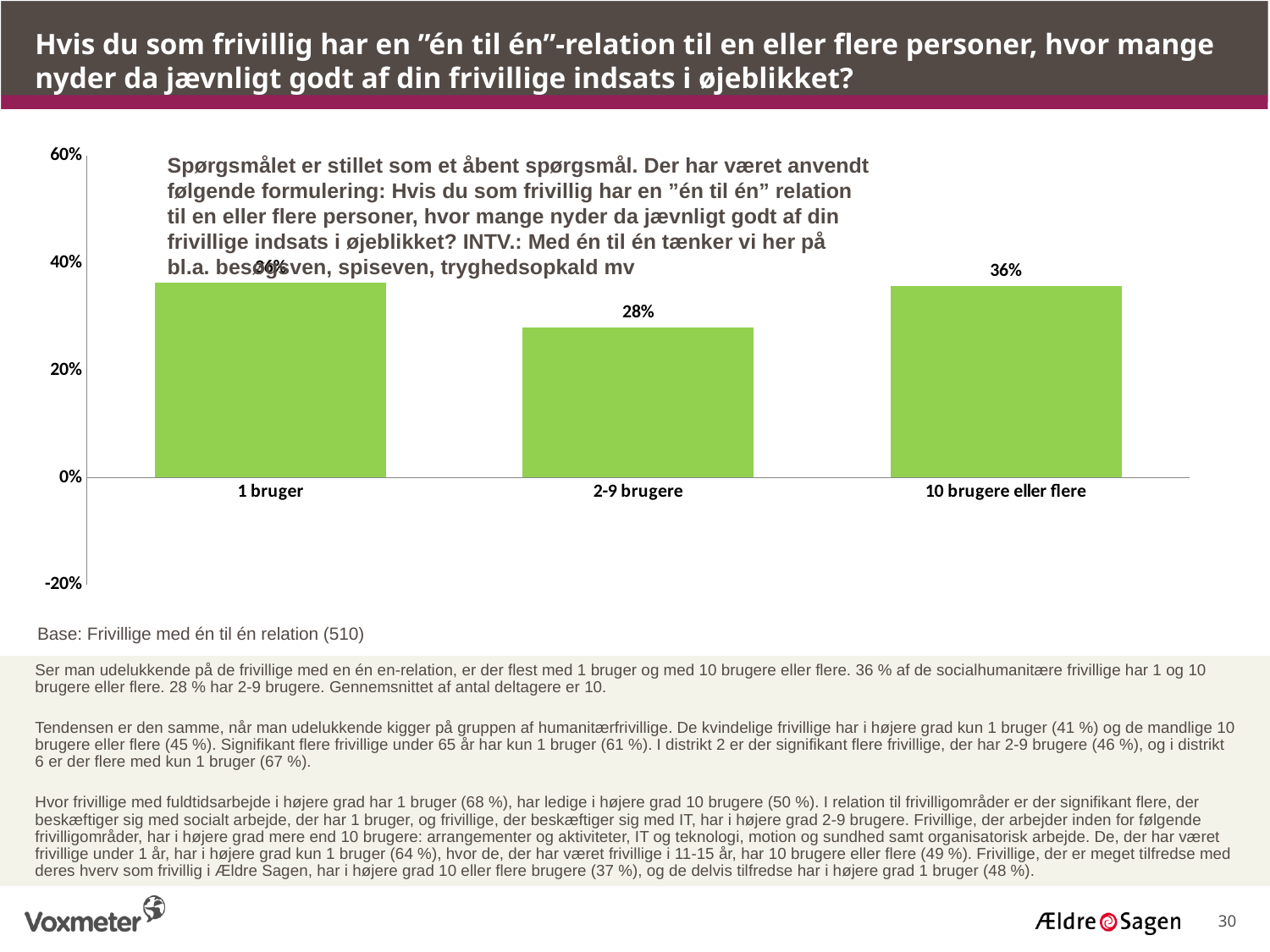
Which category has the lowest value? 2-9 brugere What kind of chart is shown on the slide? bar chart Is the value for "2-9 brugere" greater or less than 40%? less What is the difference between the values for "10 brugere eller flere" and "2-9 brugere"? 8% What is the value for "1 bruger"? 36% What is the value for "10 brugere eller flere"? 36% What is the highest value shown on the y axis? 60% How many categories are shown on the x axis? 3 Which is larger, the value for "1 bruger" or the value for "2-9 brugere"? 1 bruger What colour are the bars in the chart? green Is the value for "10 brugere eller flere" greater or less than 20%? greater What is the value for "2-9 brugere"? 28%